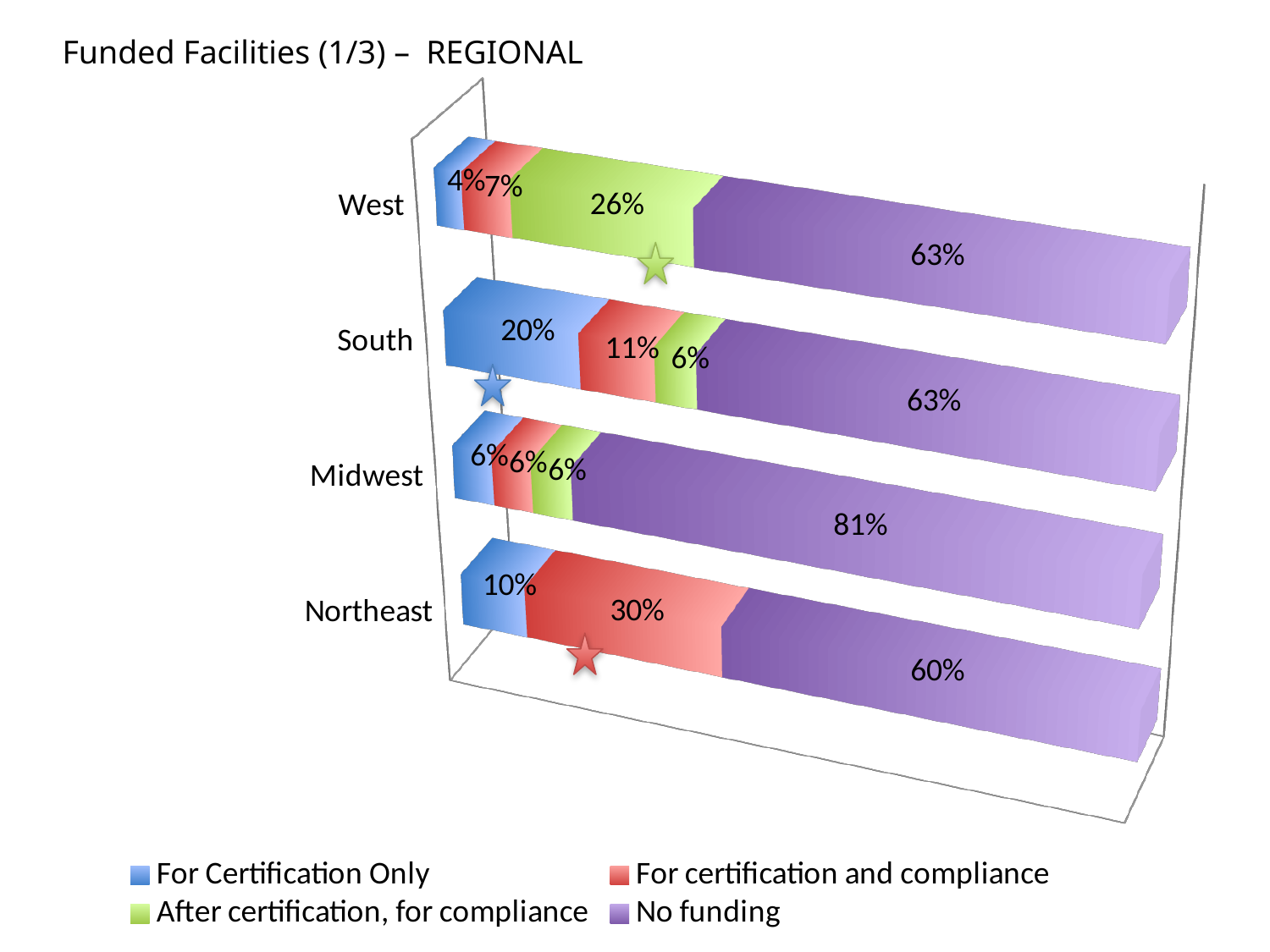
Which is larger: the 'For certification and compliance' value for the Northeast or for the South? Northeast What is the 'For certification and compliance' value for the Northeast? 30% What is the 'After certification, for compliance' value for the West? 26% How many regions are shown in the chart? 4 Which region has the lowest 'No funding' value? Northeast How many series does the legend list? 4 Which region has the highest 'For Certification Only' value? South Which region has the highest 'No funding' value? Midwest What type of chart is shown on the slide? Stacked bar chart What is the difference between the 'No funding' values for the Midwest and the Northeast? 21% What is the 'For Certification Only' value for the South? 20% What is the 'No funding' value for the Midwest? 81%